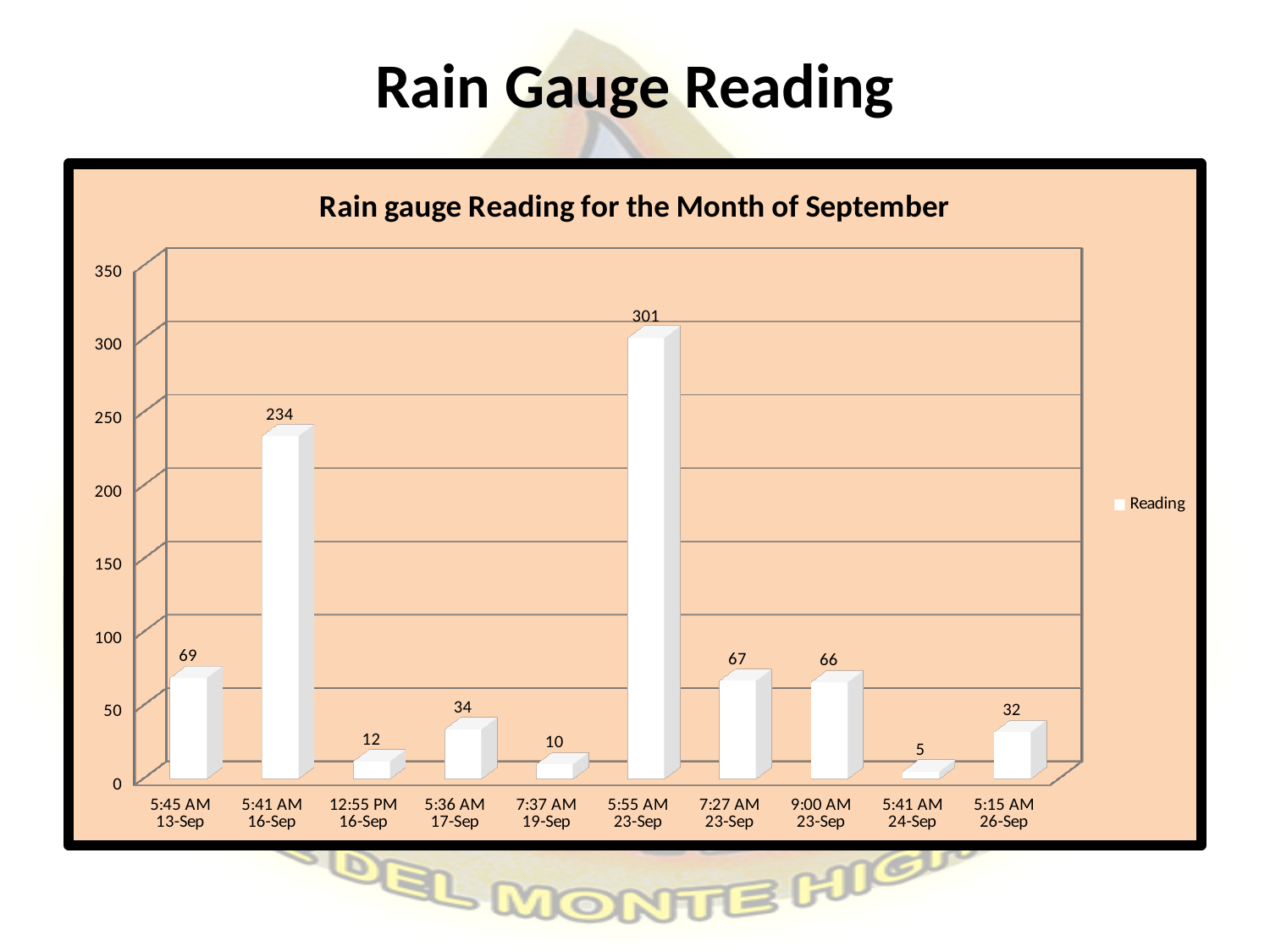
Which reading time has the highest rain gauge reading? 5:55 AM 23-Sep What is the rain gauge reading for 5:41 AM 16-Sep? 234 What is the rain gauge reading for 5:41 AM 24-Sep? 5 How many series does the legend list? 1 What kind of chart is shown on the slide? Bar chart What is the difference between the readings for 7:27 AM 23-Sep and 9:00 AM 23-Sep? 1 What is the rain gauge reading for 5:55 AM 23-Sep? 301 What is the title of the chart? Rain gauge Reading for the Month of September How many readings are plotted in the chart? 10 Which is larger, the reading for 5:45 AM 13-Sep or the reading for 5:36 AM 17-Sep? 5:45 AM 13-Sep What is the difference between the readings for 5:55 AM 23-Sep and 5:41 AM 16-Sep? 67 Which reading time has the lowest rain gauge reading? 5:41 AM 24-Sep